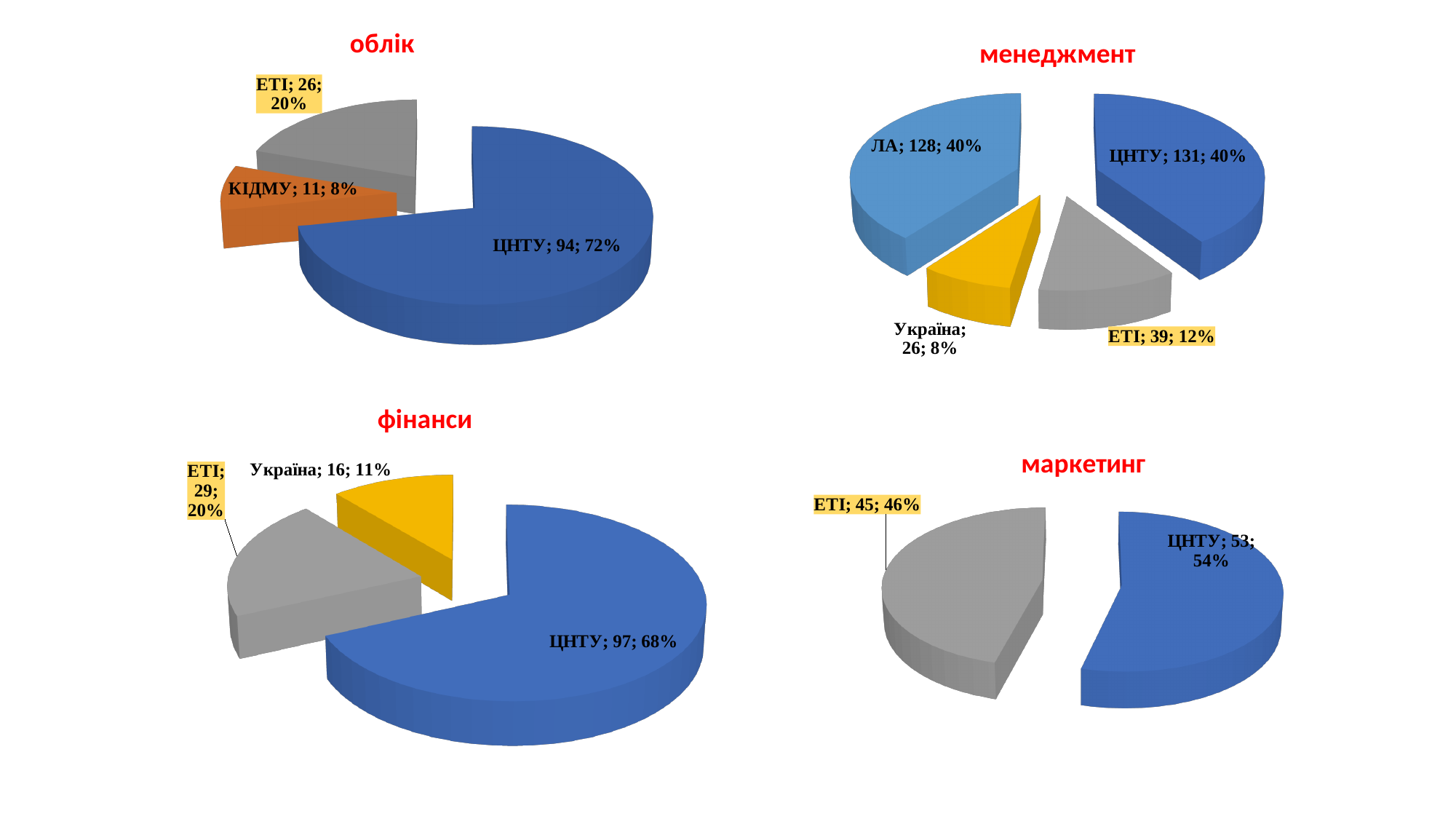
In the "облік" chart, what value is shown for ЦНТУ? 94 In the "фінанси" chart, what share of the pie does Україна have? 11% In the "маркетинг" chart, what value is shown for ЕТІ? 45 In the "менеджмент" chart, what is the difference between the values for ЕТІ and Україна? 13 In the "маркетинг" chart, what is the difference between the values for ЦНТУ and ЕТІ? 8 In the "менеджмент" chart, how many slices does the pie have? 4 In the "облік" chart, which category has the smallest slice? КІДМУ In the "облік" chart, what share of the pie does ЕТІ have? 20% In the "фінанси" chart, which is larger, the value for ЕТІ or the value for Україна? ЕТІ What type of chart is used for "маркетинг"? Pie chart In the "менеджмент" chart, what value is shown for ЛА? 128 In the "менеджмент" chart, which category has the smallest value? Україна